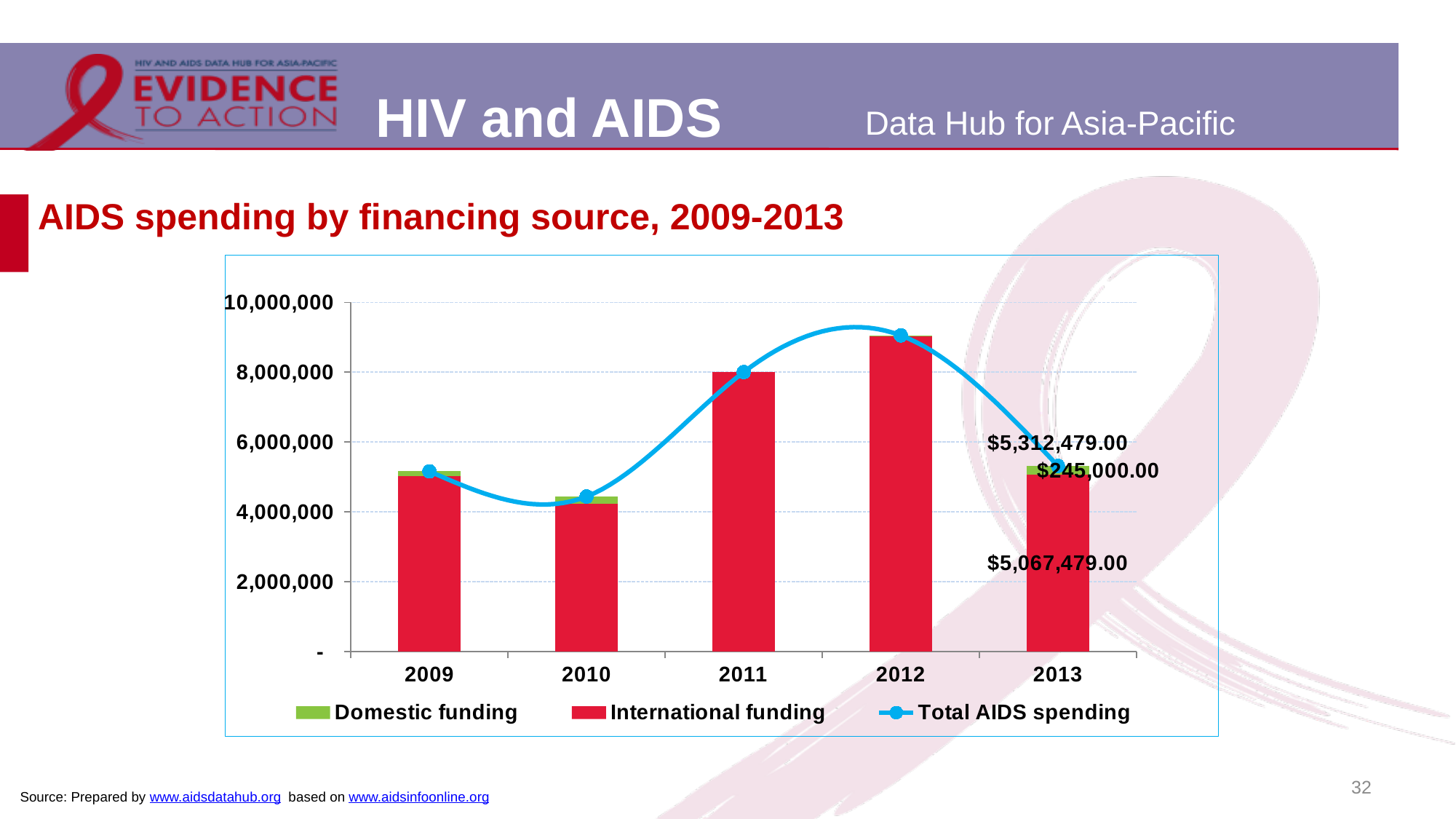
Is the total AIDS spending for 2012 greater or less than 8,000,000? greater Which year has larger international funding, 2009 or 2011? 2011 Is the total AIDS spending for 2011 greater or less than 6,000,000? greater What is the difference between international funding and domestic funding in 2013? $4,822,479.00 What kind of chart is shown on the slide? bar chart with a line How many years are shown on the x axis? 5 Which year has the lowest total AIDS spending? 2010 How many series does the legend list? 3 What is the international funding value for 2013? $5,067,479.00 What is the total AIDS spending for 2013? $5,312,479.00 Which year has the highest total AIDS spending? 2012 What is the domestic funding value for 2013? $245,000.00